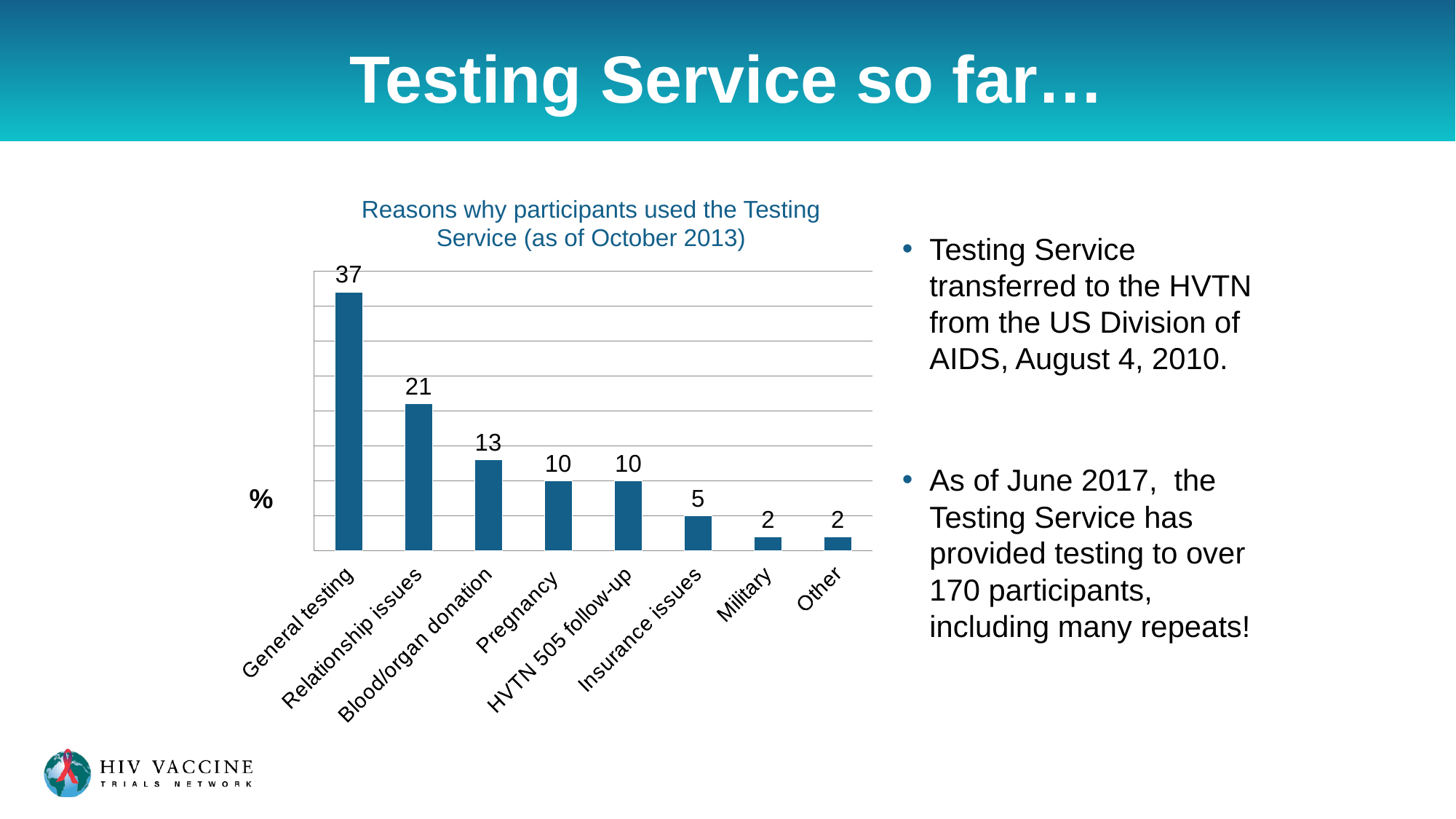
Do the values rise or fall from left to right along the x axis? Fall What is the label on the y axis of the chart? % What is the title of the chart? Reasons why participants used the Testing Service (as of October 2013) What is the value for Blood/organ donation? 13 What is the value for Relationship issues? 21 Which category has the highest value? General testing What kind of chart is shown on the slide? Bar chart Which is larger, the value for Pregnancy or the value for Insurance issues? Pregnancy What is the value for General testing? 37 What is the value for Insurance issues? 5 How many categories are shown on the x axis? 8 What is the difference between the values for General testing and Relationship issues? 16